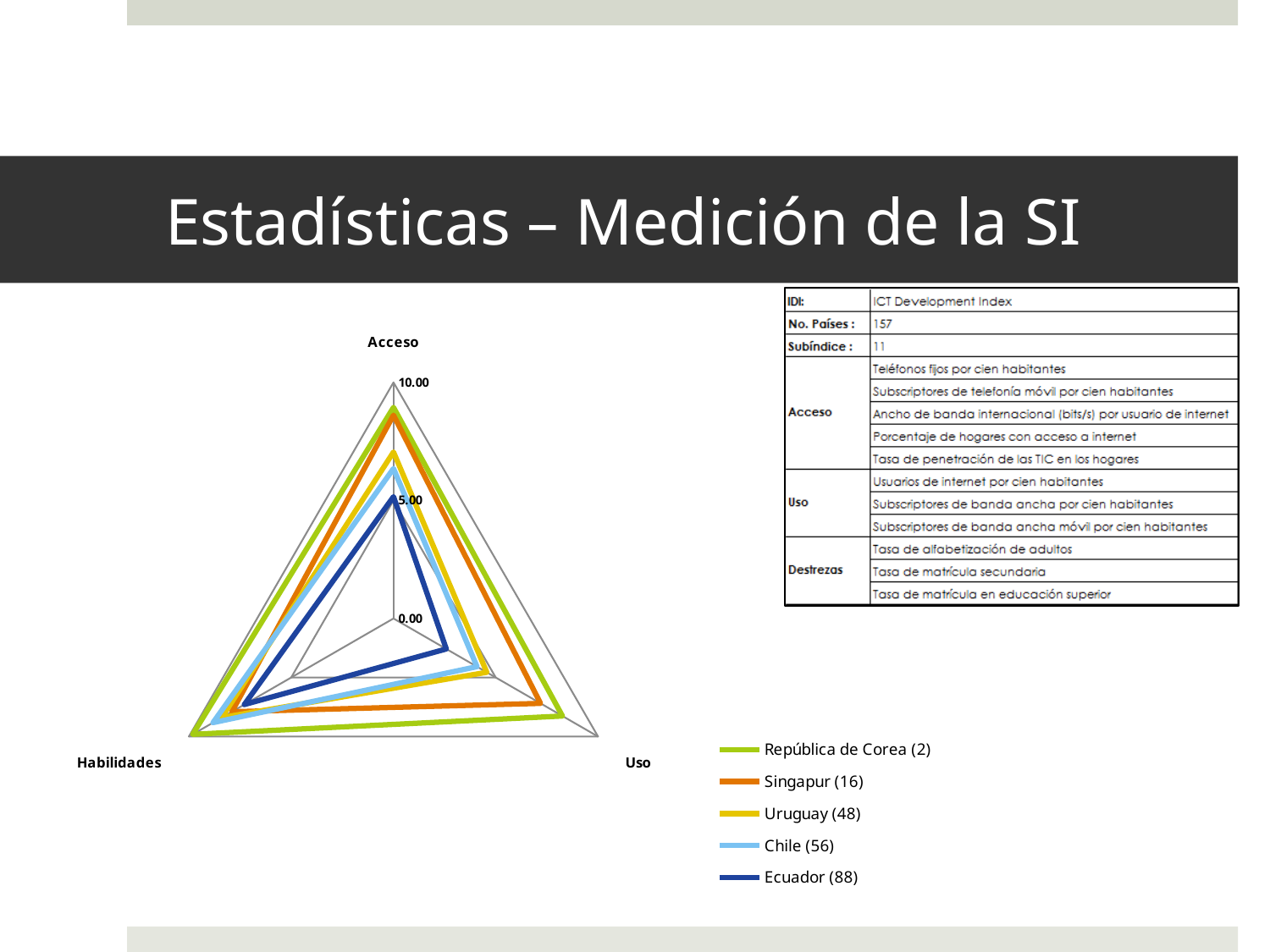
Is the value for República de Corea (2) on the Acceso axis greater or less than 5.00? greater How many axes (categories) does the radar chart have? 3 Which series has the lowest value on the Uso axis? Ecuador (88) Which series has the lowest value on the Acceso axis? Ecuador (88) Which is larger on the Uso axis: Singapur (16) or Ecuador (88)? Singapur (16) How many series does the legend list? 5 What is the maximum value shown on the radar chart's axis scale? 10.00 Is the value for Singapur (16) on the Uso axis greater or less than 5.00? greater What kind of chart is shown on the slide? Radar chart What number appears in parentheses next to Uruguay in the legend? 48 Which series has the highest value on the Acceso axis? República de Corea (2) Is the value for Ecuador (88) on the Uso axis greater or less than 5.00? less